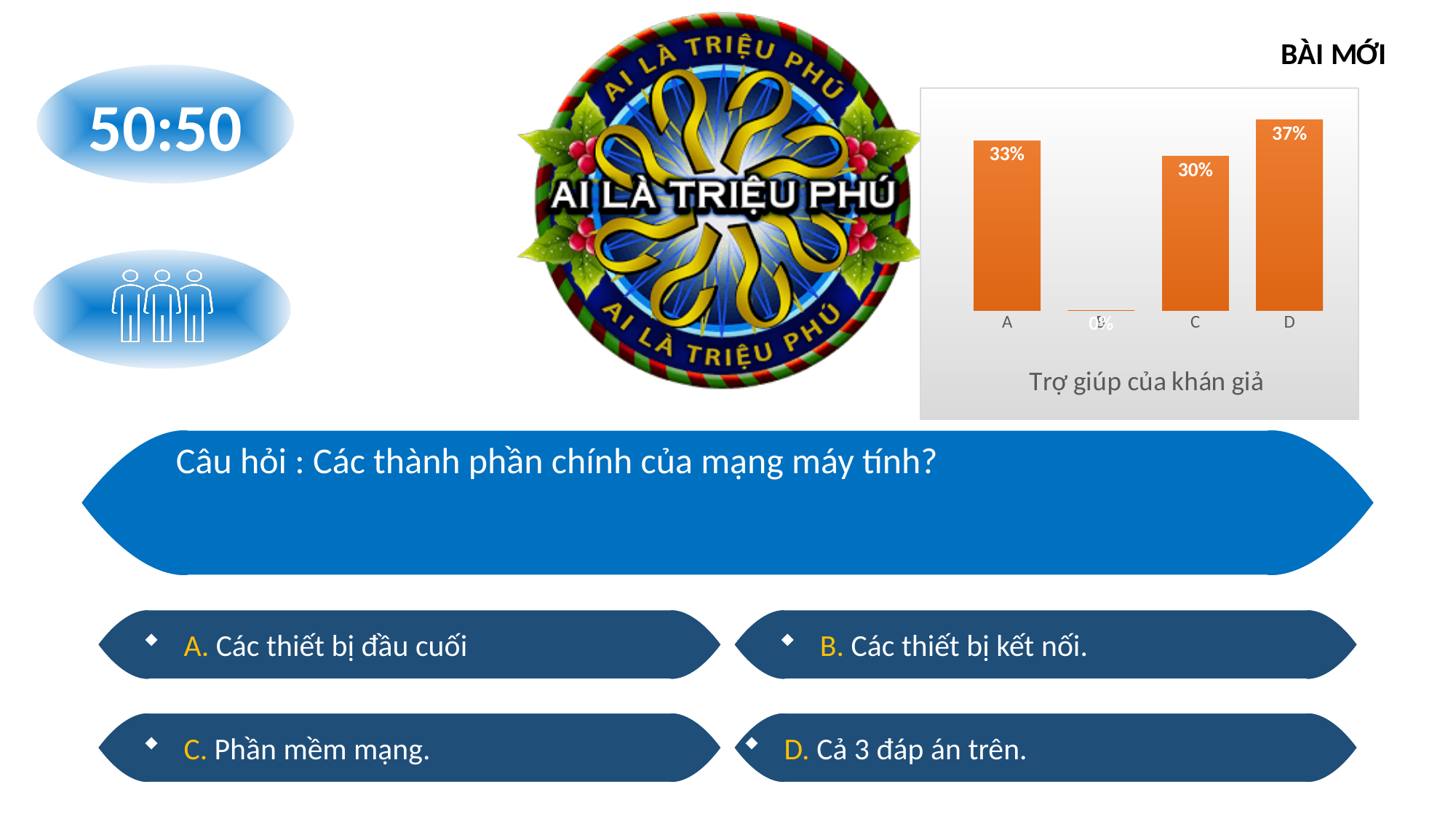
What is the value for category B in the chart? 0% What is the value for category D in the chart? 37% What is the title of the chart? Trợ giúp của khán giả How many categories are shown in the chart? 4 Which is larger, the value for A or the value for D? D What is the value for category A in the chart? 33% Which category has the highest value in the chart? D What is the difference between the values for A and C? 3% What kind of chart is shown on the slide? Bar chart What is the value for category C in the chart? 30% Which category has the lowest value in the chart? B What is the difference between the values for D and C? 7%